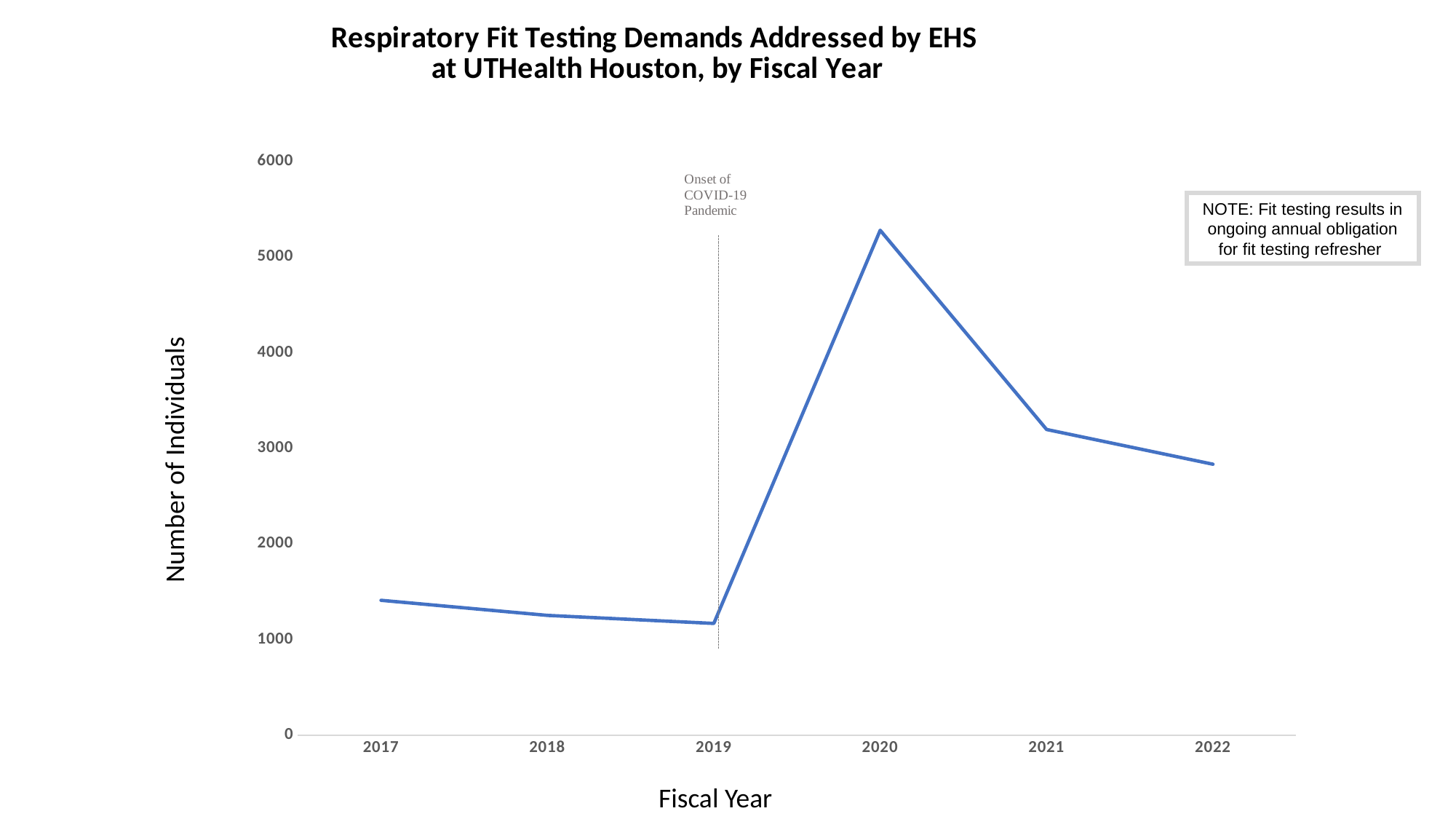
What event does the dotted vertical line at 2019 mark? Onset of COVID-19 Pandemic What kind of chart is shown on the slide? line chart Is the value for 2022 greater or less than 3000? less Is the value for 2020 greater or less than 5000? greater Do the values rise or fall from 2020 to 2022? fall How many fiscal years are plotted on the x axis? 6 Which fiscal year has the larger value, 2021 or 2022? 2021 Is the value for 2021 greater or less than 3000? greater Which fiscal year has the highest number of individuals? 2020 Which fiscal year has the lowest number of individuals? 2019 What is the label on the y axis? Number of Individuals